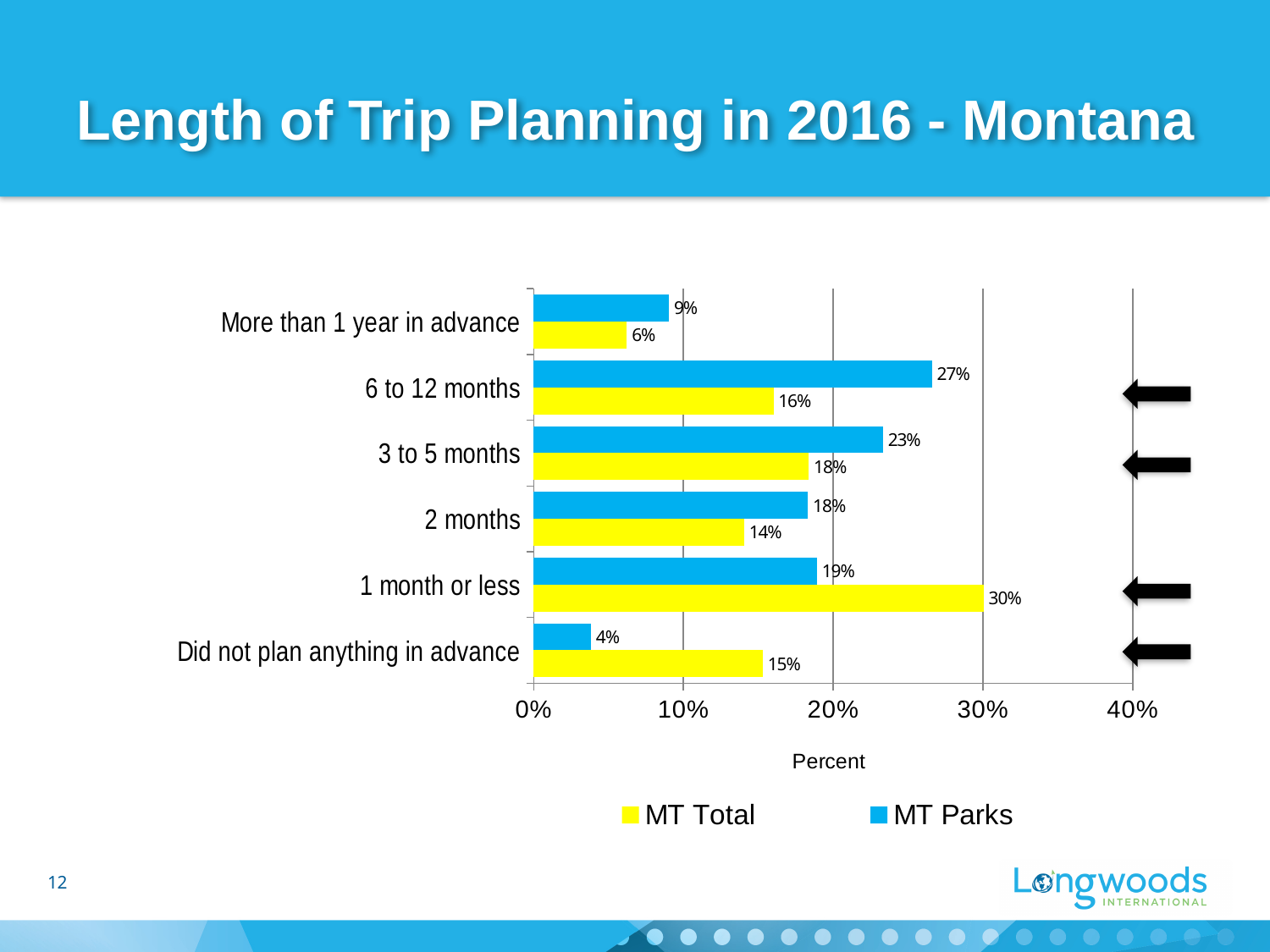
What is the MT Total value for 1 month or less? 30% What is the MT Parks value for 6 to 12 months? 27% Which category has the lowest MT Total value? More than 1 year in advance What is the difference between the MT Parks and MT Total values for 6 to 12 months? 11% What is the MT Parks value for Did not plan anything in advance? 4% Which category has the highest MT Parks value? 6 to 12 months How many series does the legend list? 2 What kind of chart is shown on the slide? Bar chart What is the MT Total value for More than 1 year in advance? 6% How many categories are shown on the chart? 6 For 1 month or less, which series has the larger value, MT Total or MT Parks? MT Total What is the title of the chart? Length of Trip Planning in 2016 - Montana